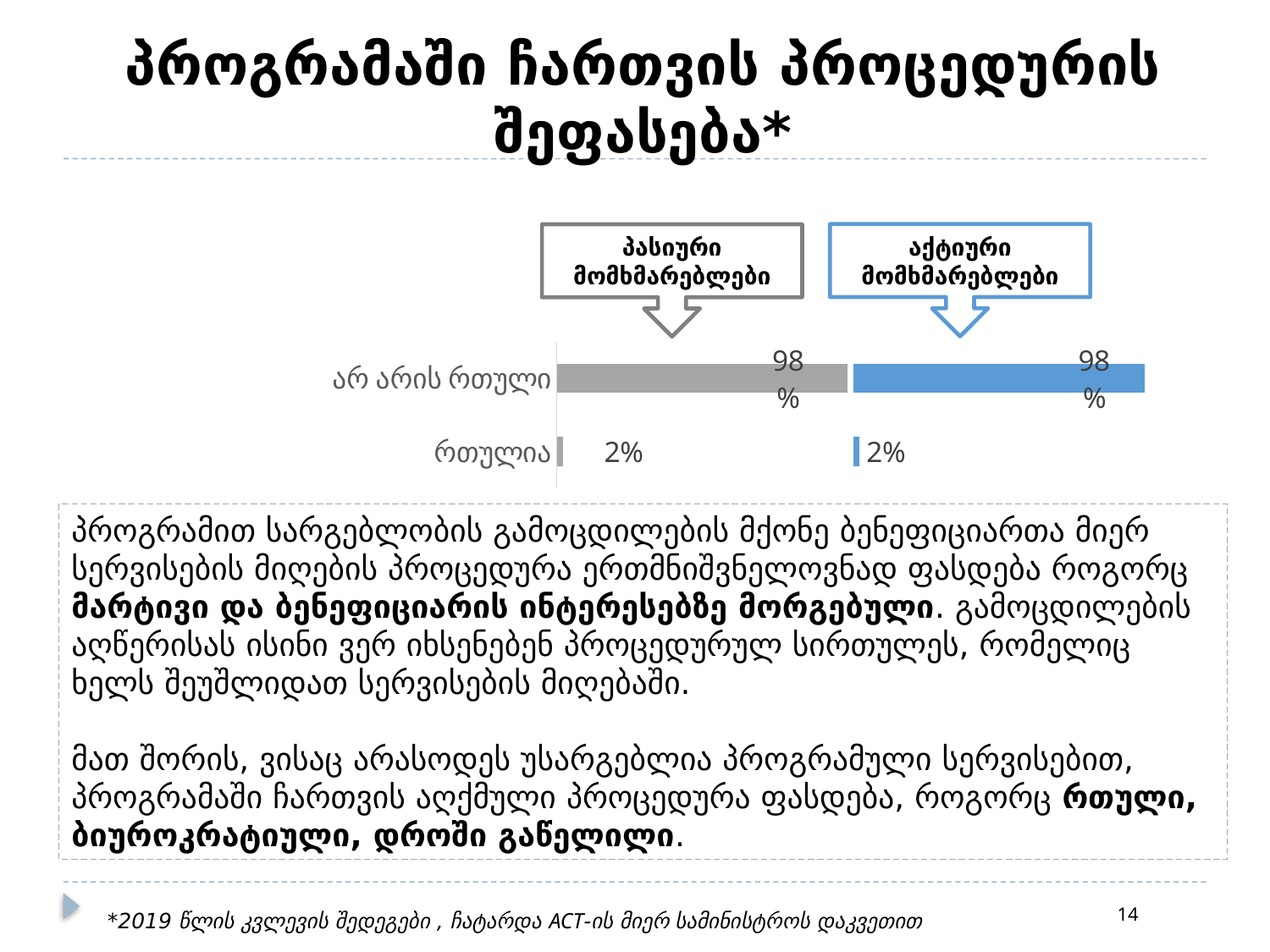
What kind of chart is shown on the slide? bar chart What is the difference between "არ არის რთული" and "რთულია" among პასიური მომხმარებლები? 96% Which colour represents აქტიური მომხმარებლები on the chart? blue How many categories are shown on the chart? 2 What is the value for "არ არის რთული" among პასიური მომხმარებლები? 98% Which is larger among აქტიური მომხმარებლები: "არ არის რთული" or "რთულია"? არ არის რთული Which category has the highest value among აქტიური მომხმარებლები? არ არის რთული Which category has the lowest value among პასიური მომხმარებლები? რთულია What is the value for "რთულია" among პასიური მომხმარებლები? 2% What is the value for "რთულია" among აქტიური მომხმარებლები? 2% How many series does the chart show? 2 What is the value for "არ არის რთული" among აქტიური მომხმარებლები? 98%